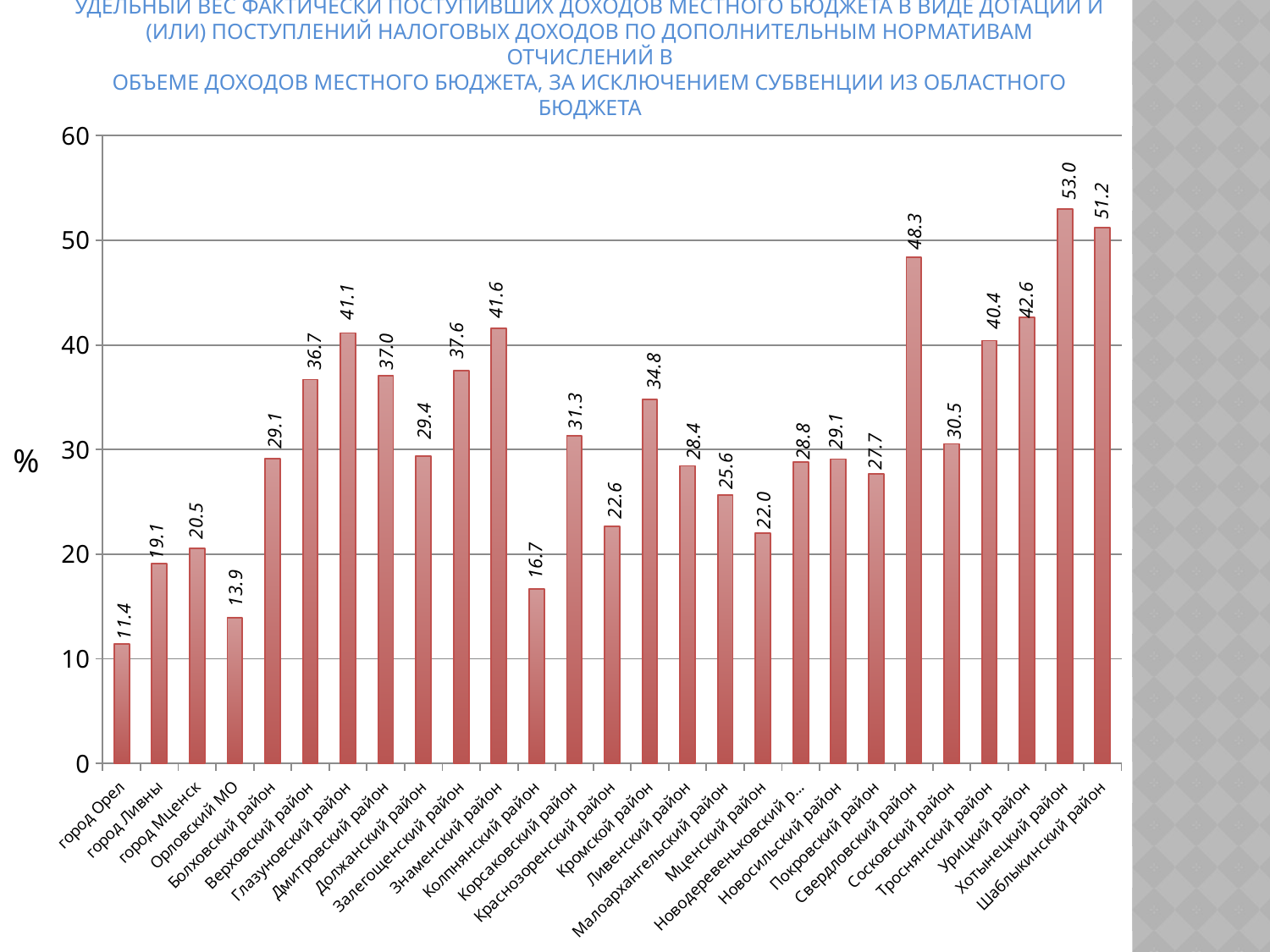
What is the value for Свердловский район? 48.3 What is the difference between the values for Глазуновский район and Знаменский район? 0.5 What is the value for город Орел? 11.4 Which category has the lowest value? город Орел How many categories are shown on the x axis? 27 What is the difference between the values for Хотынецкий район and Шаблыкинский район? 1.8 Is the value for Кромской район greater or less than 30? greater What is the value for Хотынецкий район? 53.0 What kind of chart is shown on the slide? bar chart What is the value for Колпнянский район? 16.7 Which category has the highest value? Хотынецкий район Which is larger, the value for Урицкий район or the value for Троснянский район? Урицкий район